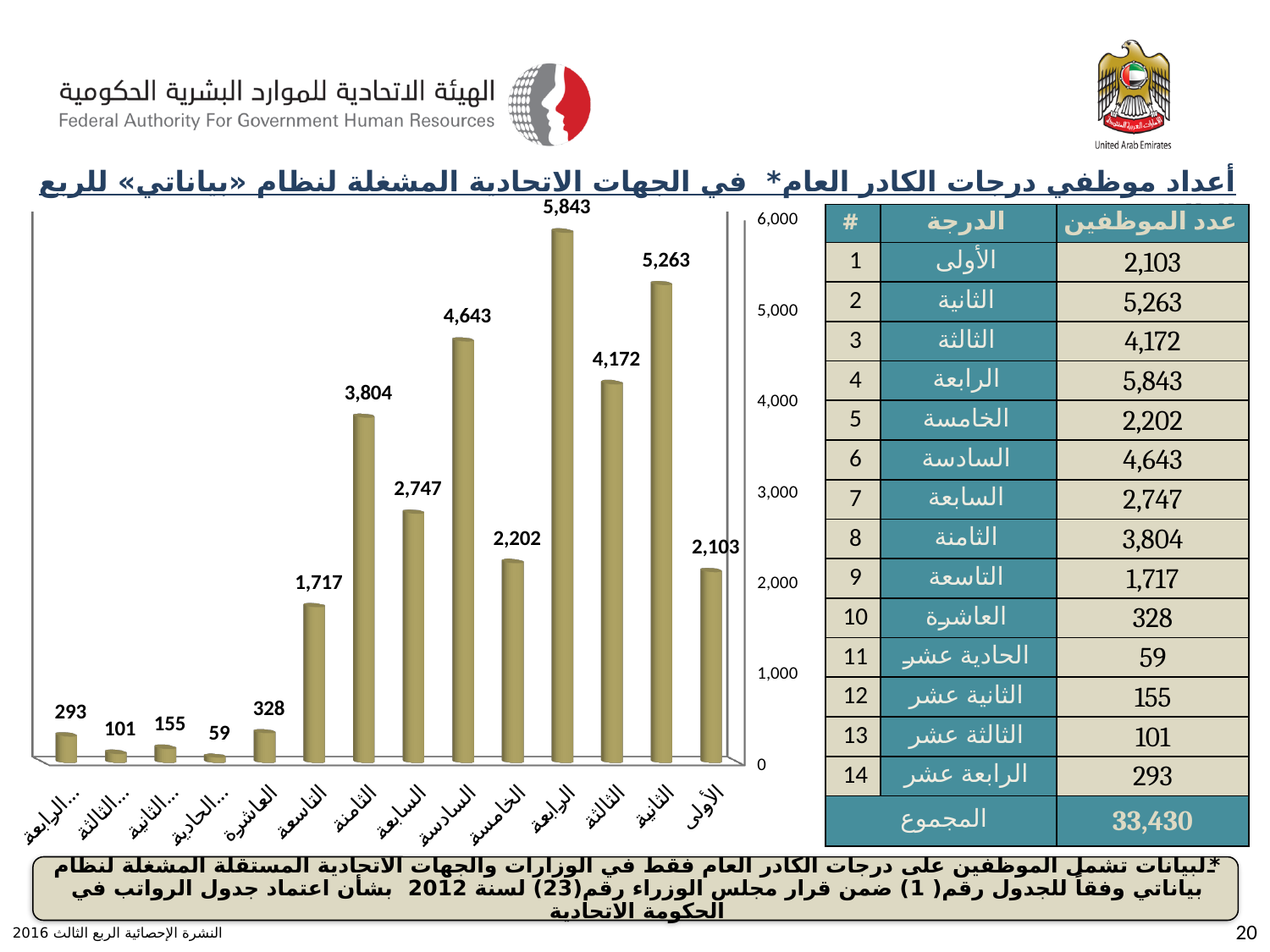
How many bars (grades) are plotted in the chart? 14 Which grade has the highest number of employees in the chart? الرابعة What is the value shown for the grade الرابعة (fourth grade)? 5,843 What type of chart is shown on the slide? Bar chart Which grade has the lowest number of employees in the chart? الحادية عشر What is the value shown for the grade التاسعة (ninth grade)? 1,717 What is the value shown for the grade الثانية (second grade)? 5,263 Is the value for الثامنة greater or less than 3,000? greater What is the total number of employees shown in the table (المجموع)? 33,430 What is the value shown for the grade العاشرة (tenth grade)? 328 What is the difference between the values for الرابعة (5,843) and الثانية (5,263)? 580 Which is larger, the value for السادسة or the value for الثالثة? السادسة